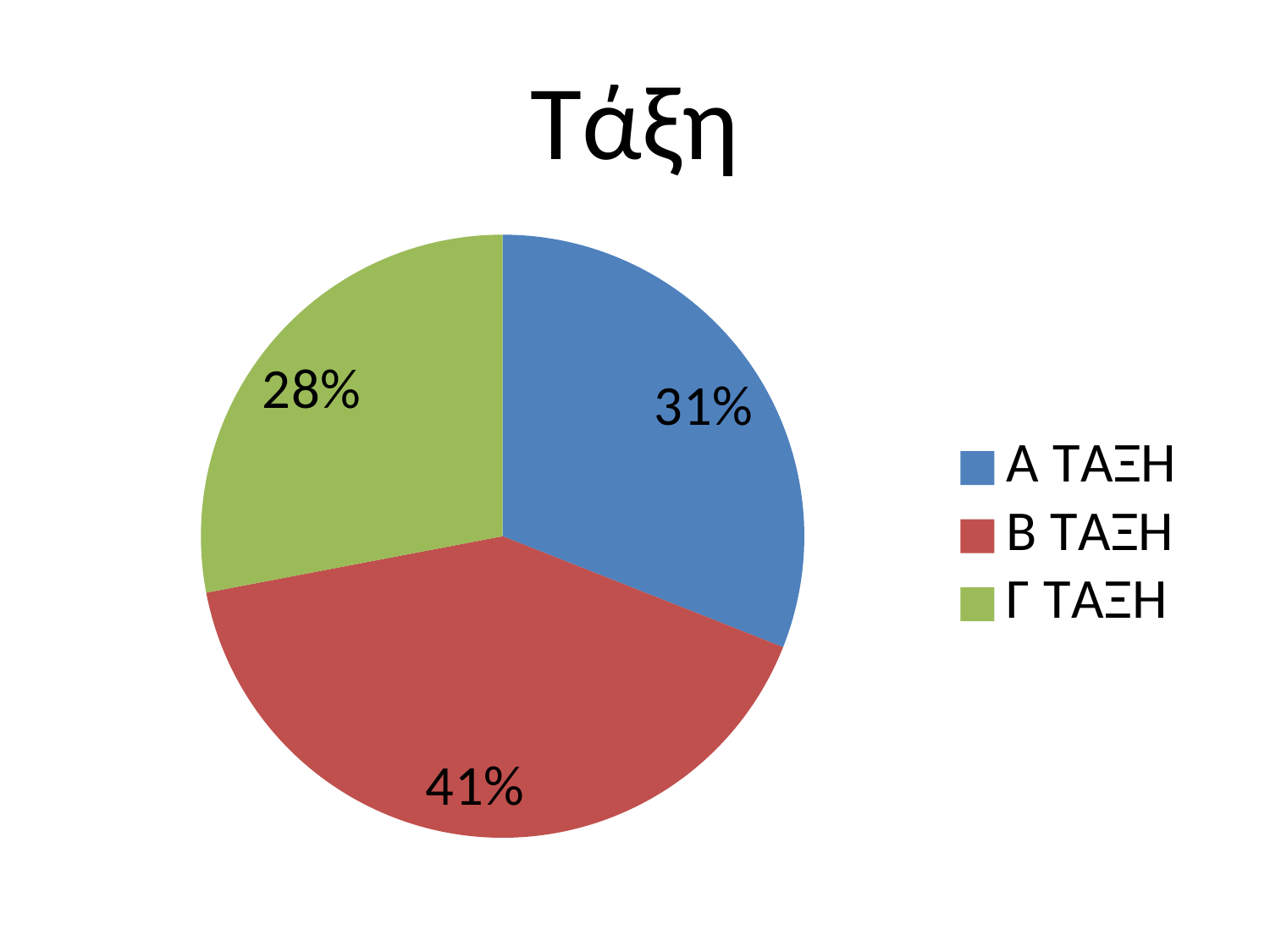
What is the title of the chart? Τάξη What percentage of the pie does Γ ΤΑΞΗ represent? 28% Which category has the largest slice of the pie? Β ΤΑΞΗ What percentage of the pie does Α ΤΑΞΗ represent? 31% What colour is the slice for Γ ΤΑΞΗ? green What is the difference in percentage points between Β ΤΑΞΗ and Γ ΤΑΞΗ? 13 What type of chart is shown on the slide? pie chart Which category has the smallest slice of the pie? Γ ΤΑΞΗ What percentage of the pie does Β ΤΑΞΗ represent? 41% How many categories are shown in the pie chart? 3 What is the difference in percentage points between Α ΤΑΞΗ and Γ ΤΑΞΗ? 3 Which is larger, the share for Α ΤΑΞΗ or the share for Β ΤΑΞΗ? Β ΤΑΞΗ